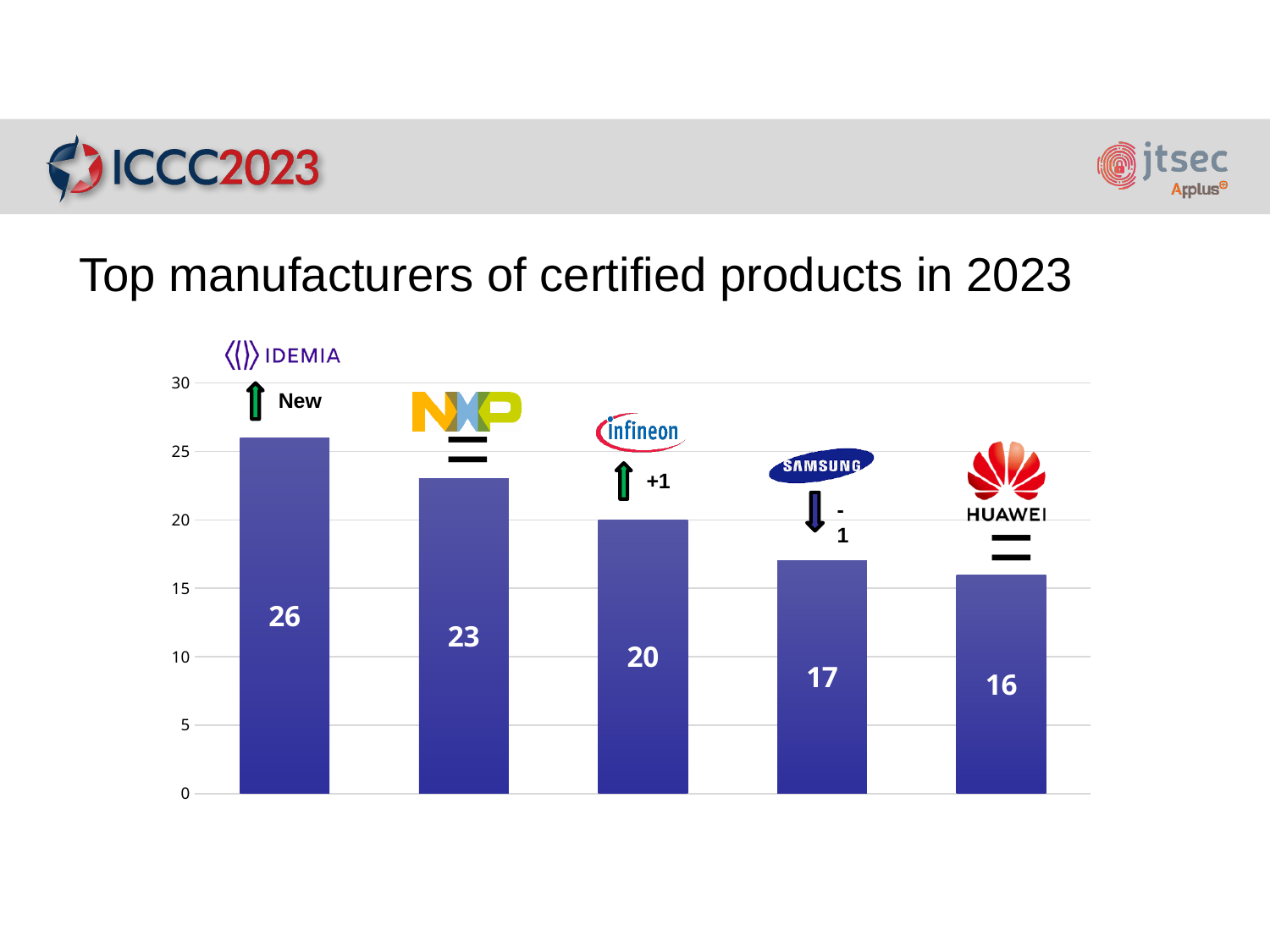
How many certified products does IDEMIA have in the chart? 26 Which has a larger value, NXP or Infineon? NXP Which manufacturer has the highest number of certified products? IDEMIA What is the difference between the values for IDEMIA and Huawei? 10 What is the value shown for Infineon? 20 What is the value shown for Huawei? 16 What is the value shown for Samsung? 17 What is the title of the slide? Top manufacturers of certified products in 2023 What is the value shown for NXP? 23 How many manufacturers are shown in the chart? 5 What type of chart is shown on the slide? Bar chart Which manufacturer has the lowest number of certified products? Huawei